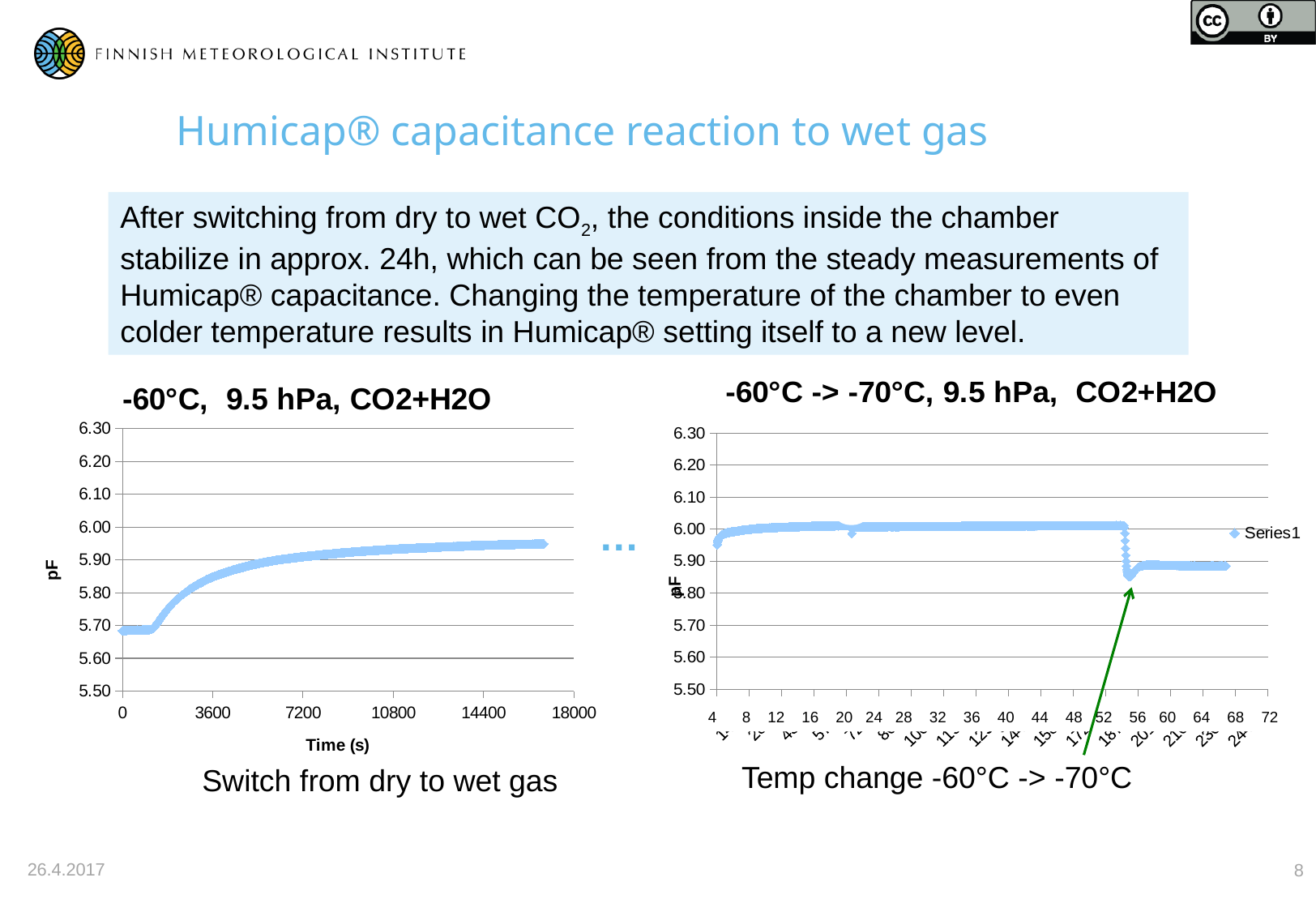
On the right chart titled "-60°C -> -70°C, 9.5 hPa, CO2+H2O", what is the highest tick value shown on the y axis? 6.30 On the right chart titled "-60°C -> -70°C, 9.5 hPa, CO2+H2O", how many series does the legend list? 1 On the left chart titled "-60°C, 9.5 hPa, CO2+H2O", which is larger: the value at time 3600 or the value at time 10800? 10800 On the left chart titled "-60°C, 9.5 hPa, CO2+H2O", is the value at time 0 greater or less than 5.80? less On the right chart titled "-60°C -> -70°C, 9.5 hPa, CO2+H2O", what kind of chart is it? scatter chart On the right chart titled "-60°C -> -70°C, 9.5 hPa, CO2+H2O", which is larger: the value at x = 40 or the value at x = 64? x = 40 On the left chart titled "-60°C, 9.5 hPa, CO2+H2O", do the values rise or fall as time increases? rise On the left chart titled "-60°C, 9.5 hPa, CO2+H2O", what is the label of the y axis? pF On the right chart titled "-60°C -> -70°C, 9.5 hPa, CO2+H2O", is the value at x = 40 greater or less than 5.90? greater On the right chart titled "-60°C -> -70°C, 9.5 hPa, CO2+H2O", is the value at x = 64 greater or less than 6.00? less On the left chart titled "-60°C, 9.5 hPa, CO2+H2O", what is the label of the x axis? Time (s)